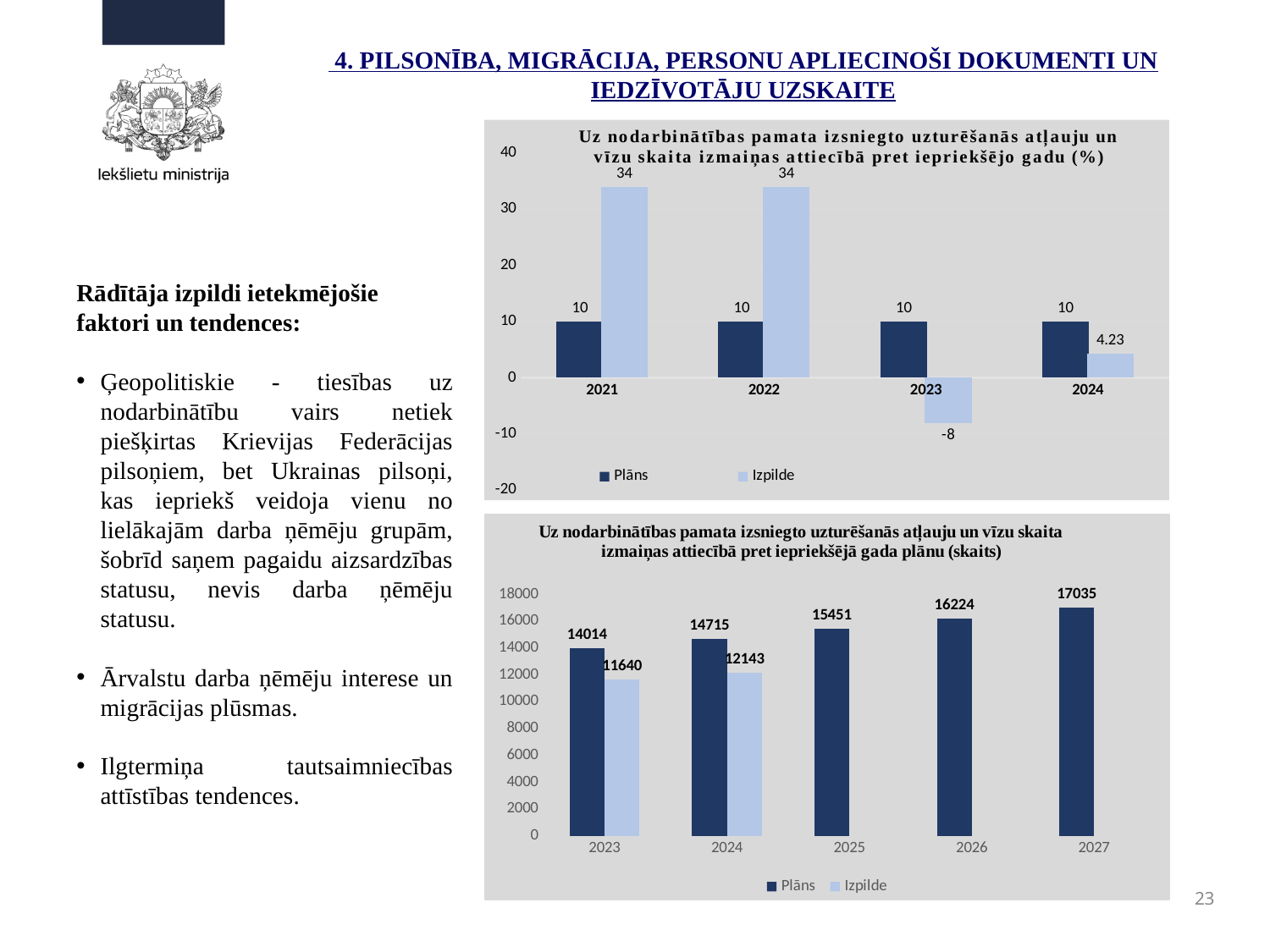
In the bottom chart (count vs previous year's plan), what is the Izpilde value for 2024? 12143 In the top chart (percentage change vs previous year), what is the difference between the Izpilde and Plāns values for 2021? 24 In the top chart (percentage change vs previous year), what is the Izpilde value for 2023? -8 In the bottom chart (count vs previous year's plan), what is the Plāns value for 2027? 17035 In the top chart (percentage change vs previous year), what is the Plāns value for 2022? 10 In the bottom chart (count vs previous year's plan), which year has the highest Plāns value? 2027 In the bottom chart (count vs previous year's plan), do the Plāns values rise or fall from 2023 to 2027? rise In the top chart (percentage change vs previous year), which year has the lowest Izpilde value? 2023 What kind of chart is the bottom chart (count vs previous year's plan)? bar chart In the top chart (percentage change vs previous year), how many series does the legend list? 2 In the top chart (percentage change vs previous year), what is the Izpilde value for 2024? 4.23 In the bottom chart (count vs previous year's plan), what is the difference between the Plāns and Izpilde values for 2023? 2374